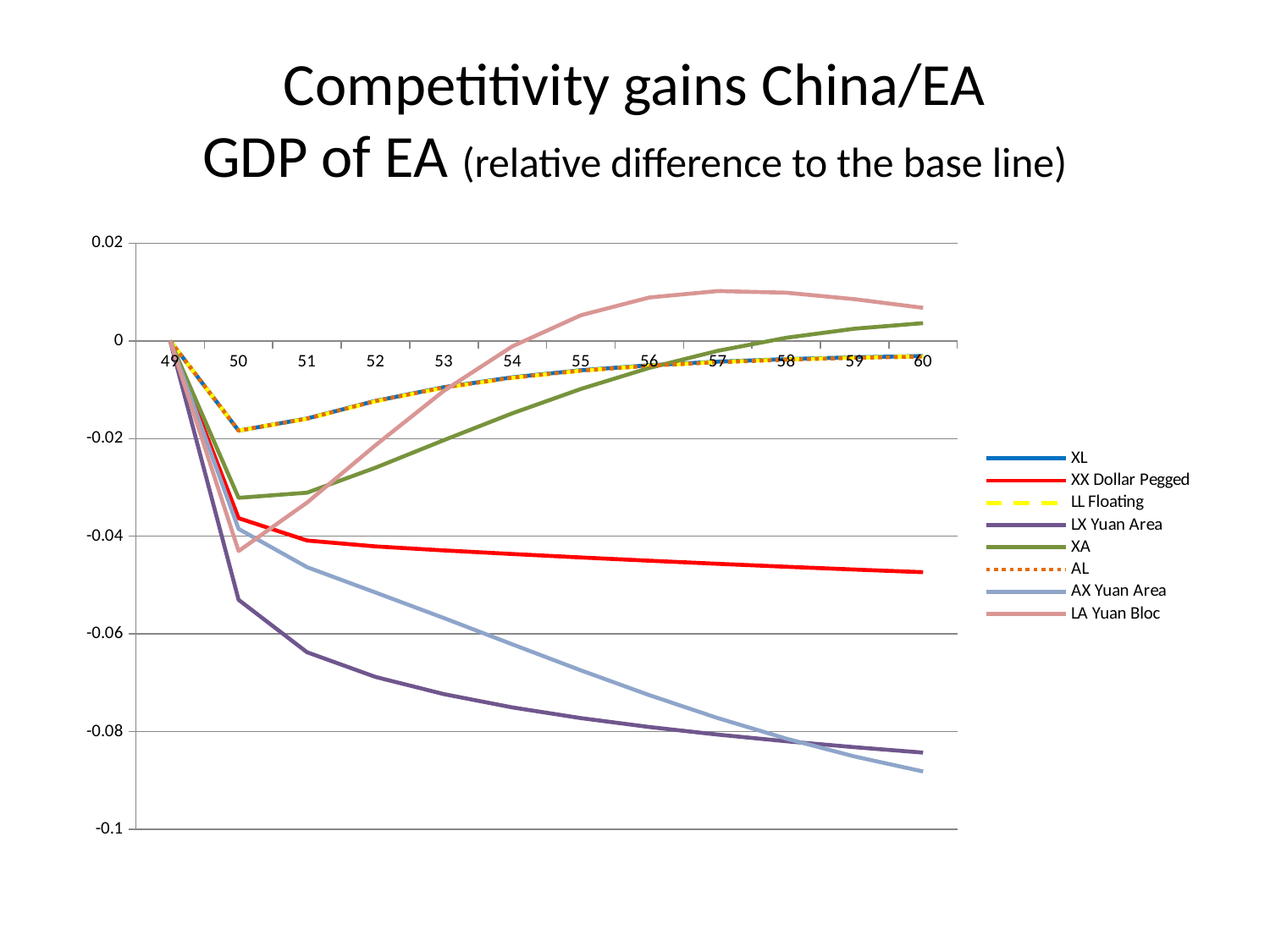
Does the XX Dollar Pegged line rise or fall from 50 to 60? fall Is the value for XA at 50 greater or less than -0.04? greater Is the value for LA Yuan Bloc at 57 greater or less than 0? greater How many series does the legend list? 8 Which legend entry is drawn as a yellow dashed line? LL Floating At 60, which is larger: LA Yuan Bloc or XX Dollar Pegged? LA Yuan Bloc What kind of chart is shown on the slide? line chart Is the value for AX Yuan Area at 60 greater or less than -0.08? less Which series has the lowest value at 50? LX Yuan Area Which series has the highest value at 60? LA Yuan Bloc How many points are labelled along the x axis? 12